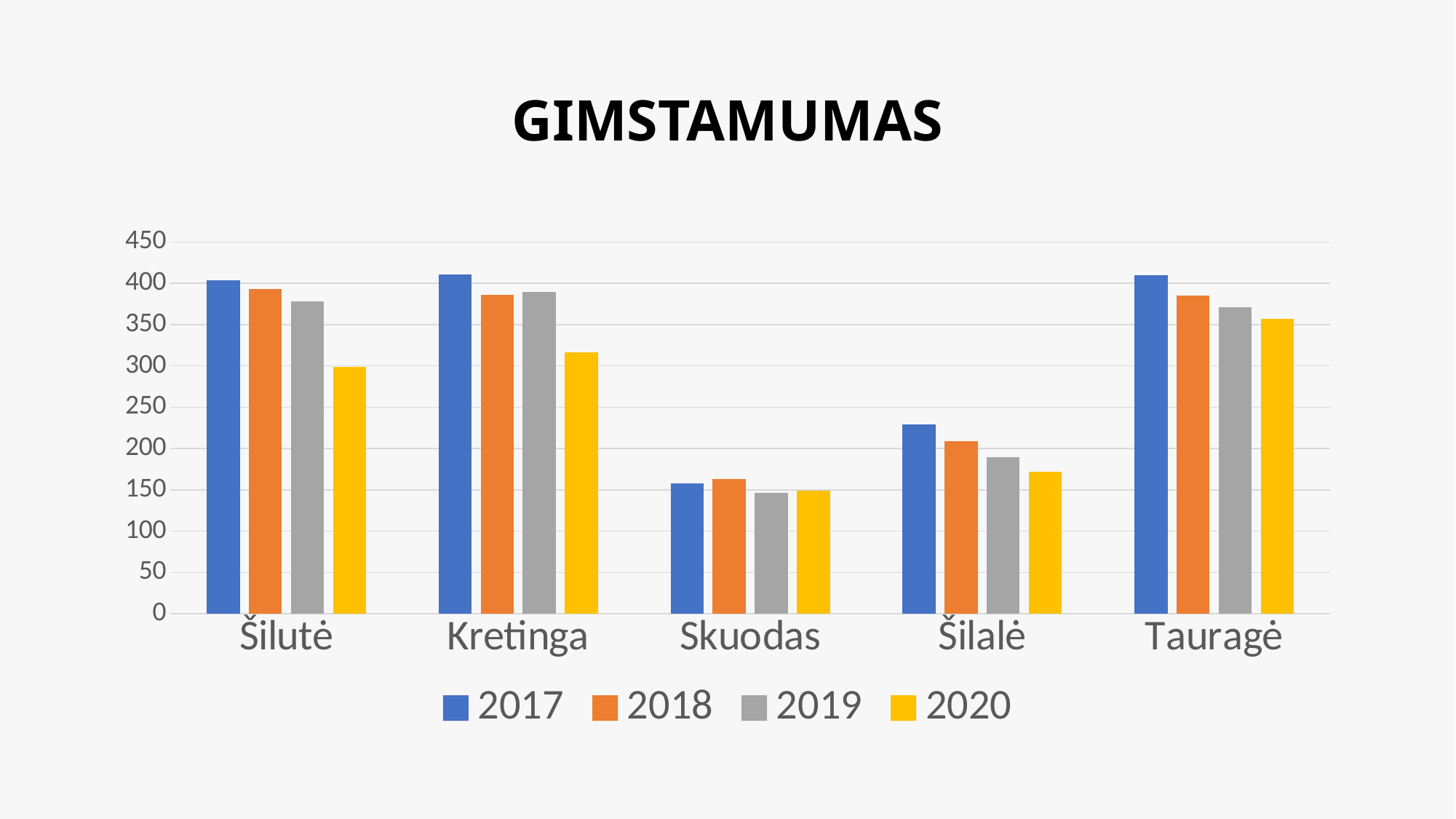
For Skuodas, which is larger: the 2018 value or the 2019 value? 2018 For Šilutė, which is larger: the 2017 value or the 2020 value? 2017 Which category has the lowest value for 2017? Skuodas How many series does the legend list? 4 Do the values for Tauragė rise or fall from 2017 to 2020? fall What is the title of the chart? GIMSTAMUMAS Is the value for Šilutė in 2020 greater or less than 250? greater Is the value for Šilalė in 2017 greater or less than 200? greater Which category has the highest value for 2020? Tauragė How many categories are shown on the x axis? 5 What kind of chart is shown on the slide? bar chart Is the value for Kretinga in 2020 greater or less than 300? greater